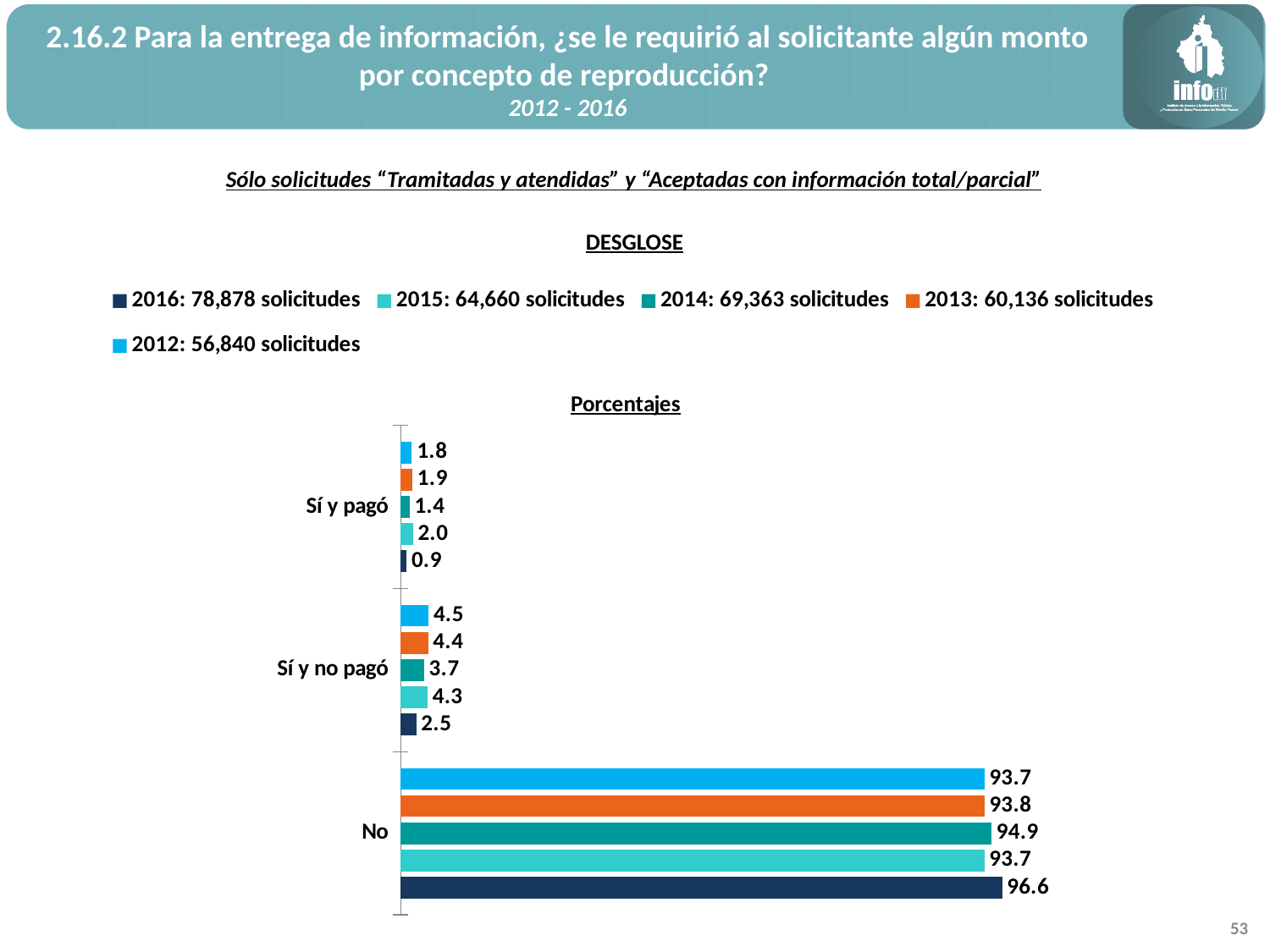
What is the value for 2014 in the "Sí y no pagó" category? 3.7 What is the title shown above the chart? Porcentajes Which year has the highest value in the "No" category? 2016 What type of chart is shown on the slide? bar chart What is the value for 2016 in the "No" category? 96.6 What is the difference between the 2016 and 2014 values in the "No" category? 1.7 What is the value for 2015 in the "Sí y pagó" category? 2.0 How many categories are shown on the chart? 3 According to the legend, how many solicitudes were there in 2013? 60,136 solicitudes Which year has the lowest value in the "Sí y pagó" category? 2016 How many series does the legend list? 5 Which is larger in the "Sí y no pagó" category: the value for 2012 or the value for 2016? 2012